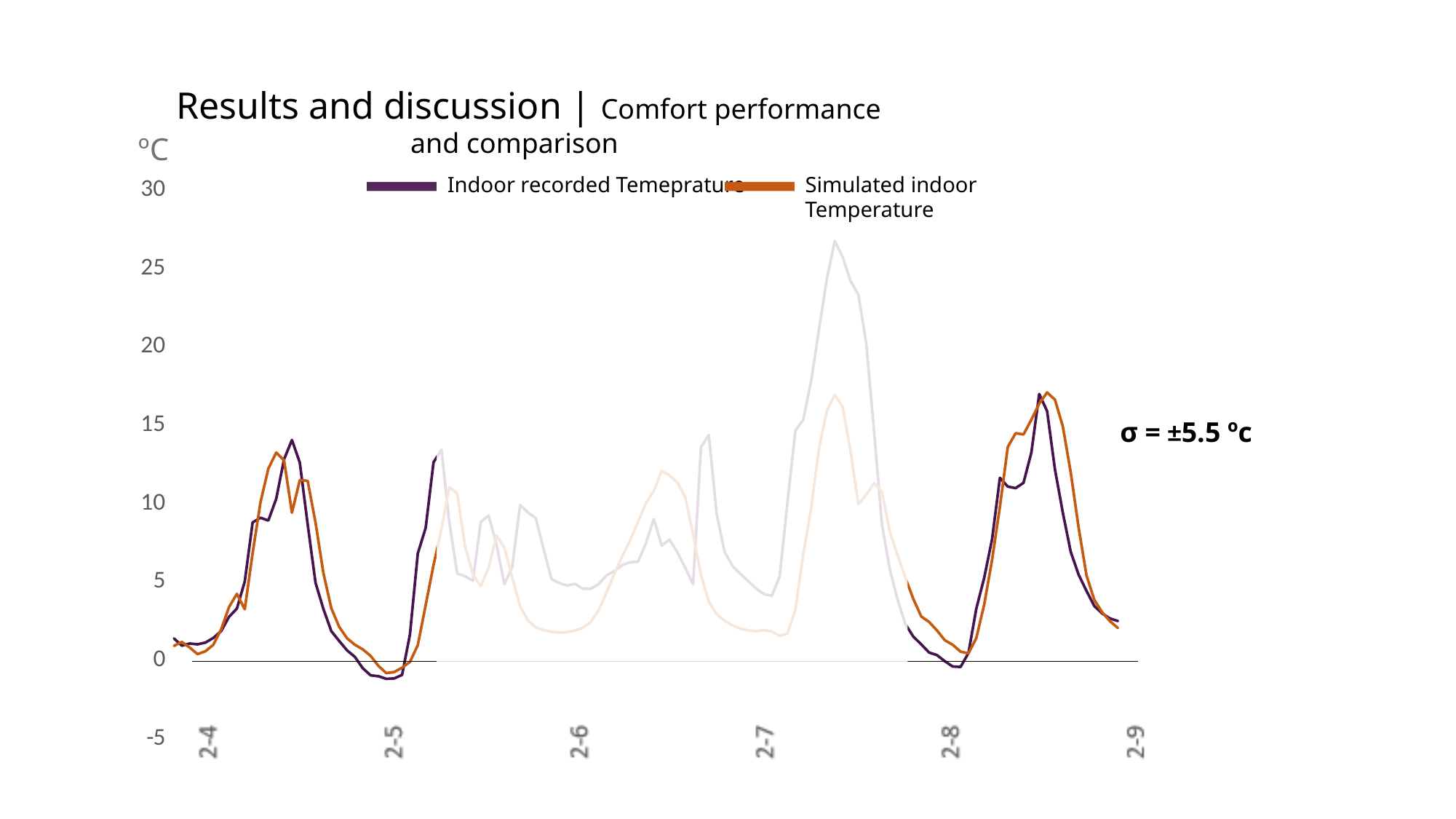
Is the peak of Simulated indoor Temperature between 2-8 and 2-9 greater or less than 15? greater What standard deviation value is annotated on the chart? σ = ±5.5 °c How many date labels are shown along the x axis? 6 What are the two series named in the legend? Indoor recorded Temeprature and Simulated indoor Temperature Is the highest value reached by Indoor recorded Temeprature greater or less than 25? greater Is the lowest value of Indoor recorded Temeprature near 2-5 greater or less than 0? less What kind of chart is shown on the slide? line chart Just after 2-8, does the Simulated indoor Temperature rise or fall? rise How many series does the legend list? 2 Which series reaches the higher peak value over the whole chart? Indoor recorded Temeprature